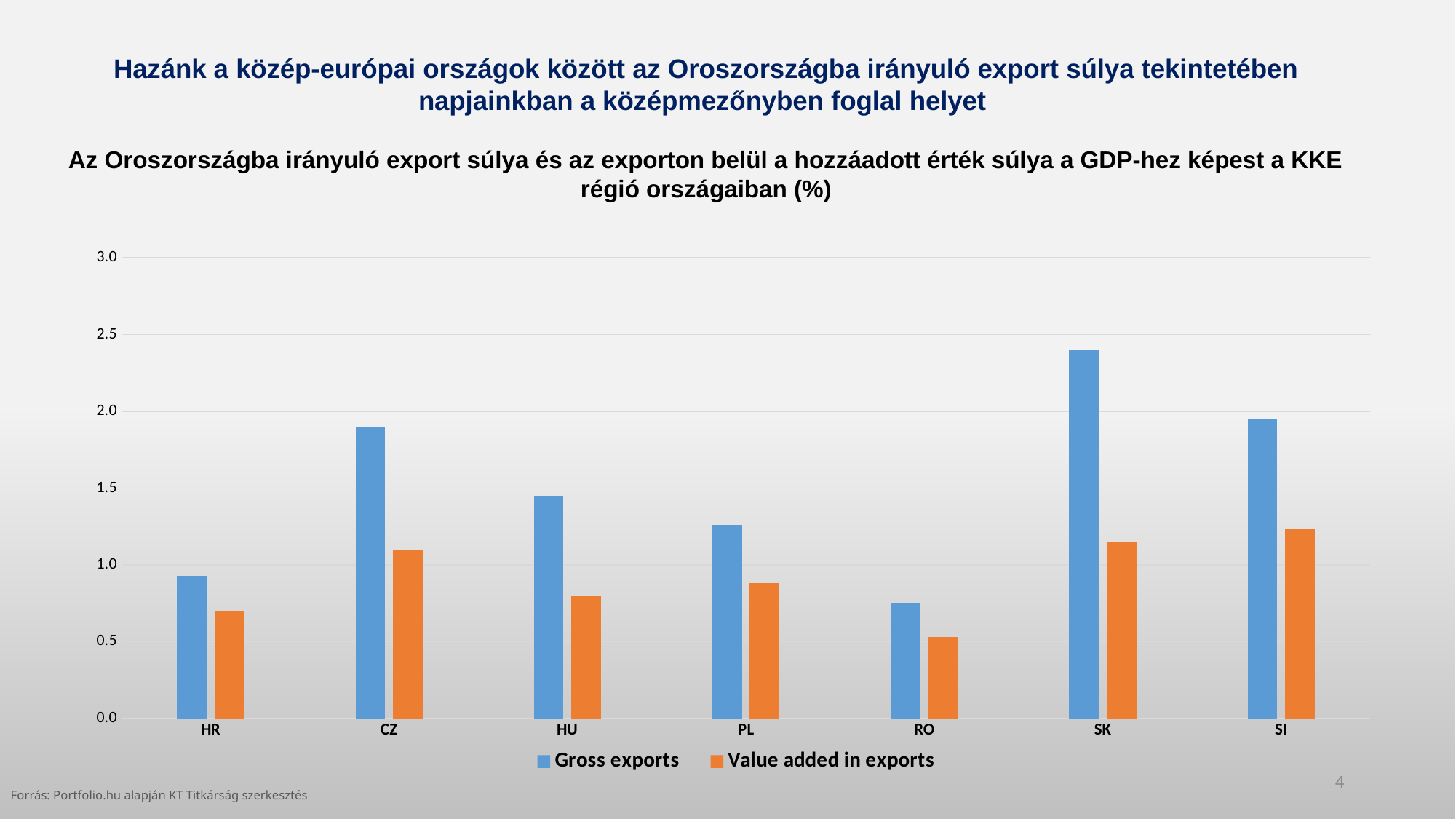
How many countries are shown on the x axis of the chart? 7 What kind of chart is shown on the slide? bar chart Is the Gross exports value for SK greater or less than 2.0? greater Which is larger, the Value added in exports value for PL or for RO? PL How many series does the legend list? 2 Is the Value added in exports value for CZ greater or less than 1.0? greater Which is larger, the Gross exports value for CZ or for HU? CZ Which country has the highest Gross exports value? SK Which colour represents the Gross exports series in the chart? blue Is the Gross exports value for RO greater or less than 1.0? less Which country has the lowest Value added in exports value? RO Which country has the lowest Gross exports value? RO